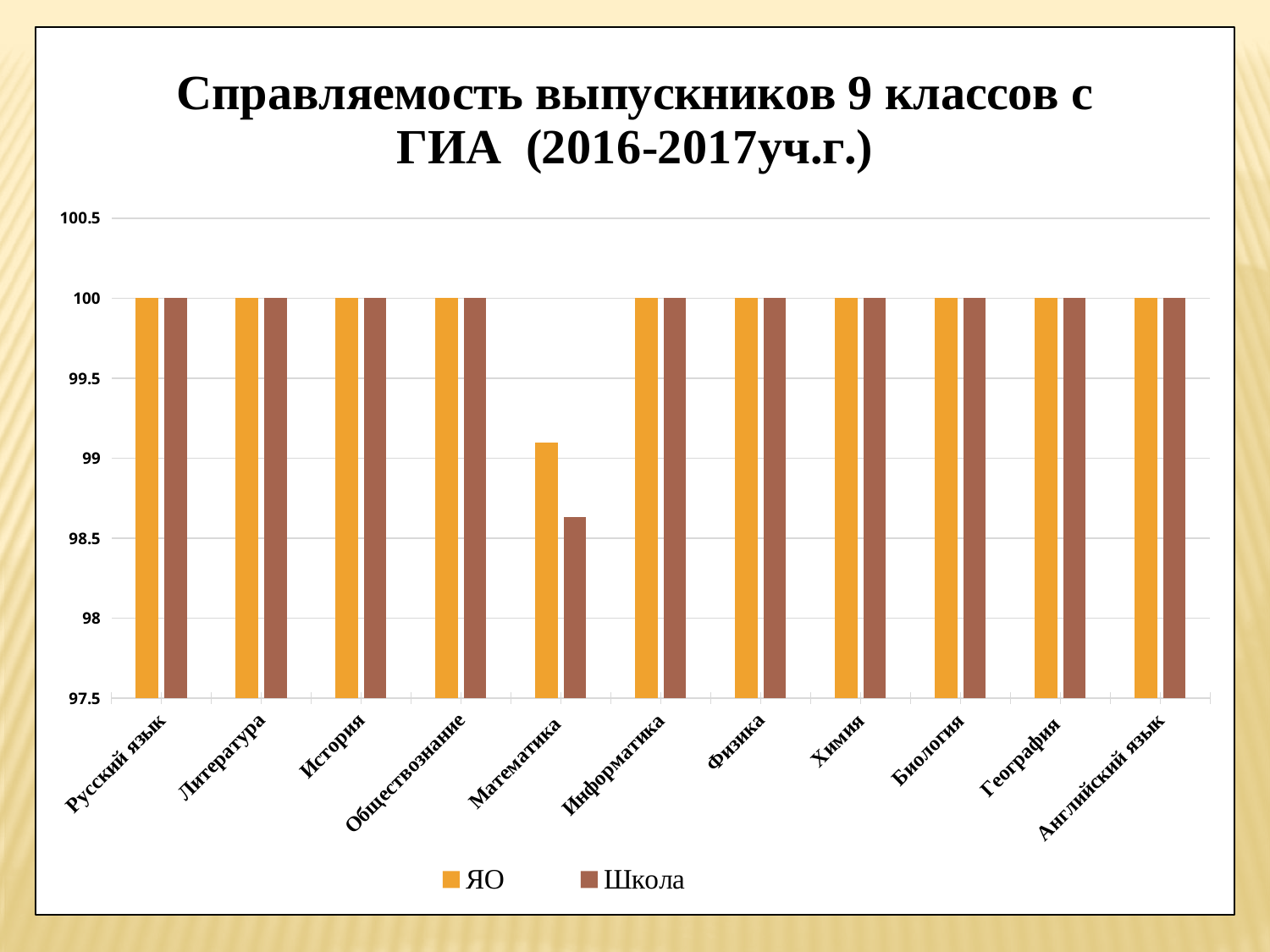
Which subject has the lowest value for the ЯО series? Математика What is the title of the chart? Справляемость выпускников 9 классов с ГИА (2016-2017уч.г.) What are the two series named in the legend? ЯО and Школа How many series does the legend list? 2 For Математика, which series has the larger value, ЯО or Школа? ЯО How many subject categories are shown on the x axis? 11 What is the value for Школа for Физика? 100 What kind of chart is shown on the slide? bar chart Is the value for ЯО for Математика greater or less than 99? greater What is the value for ЯО for Русский язык? 100 Which subject has the lowest value for the Школа series? Математика Is the value for Школа for Математика greater or less than 99? less